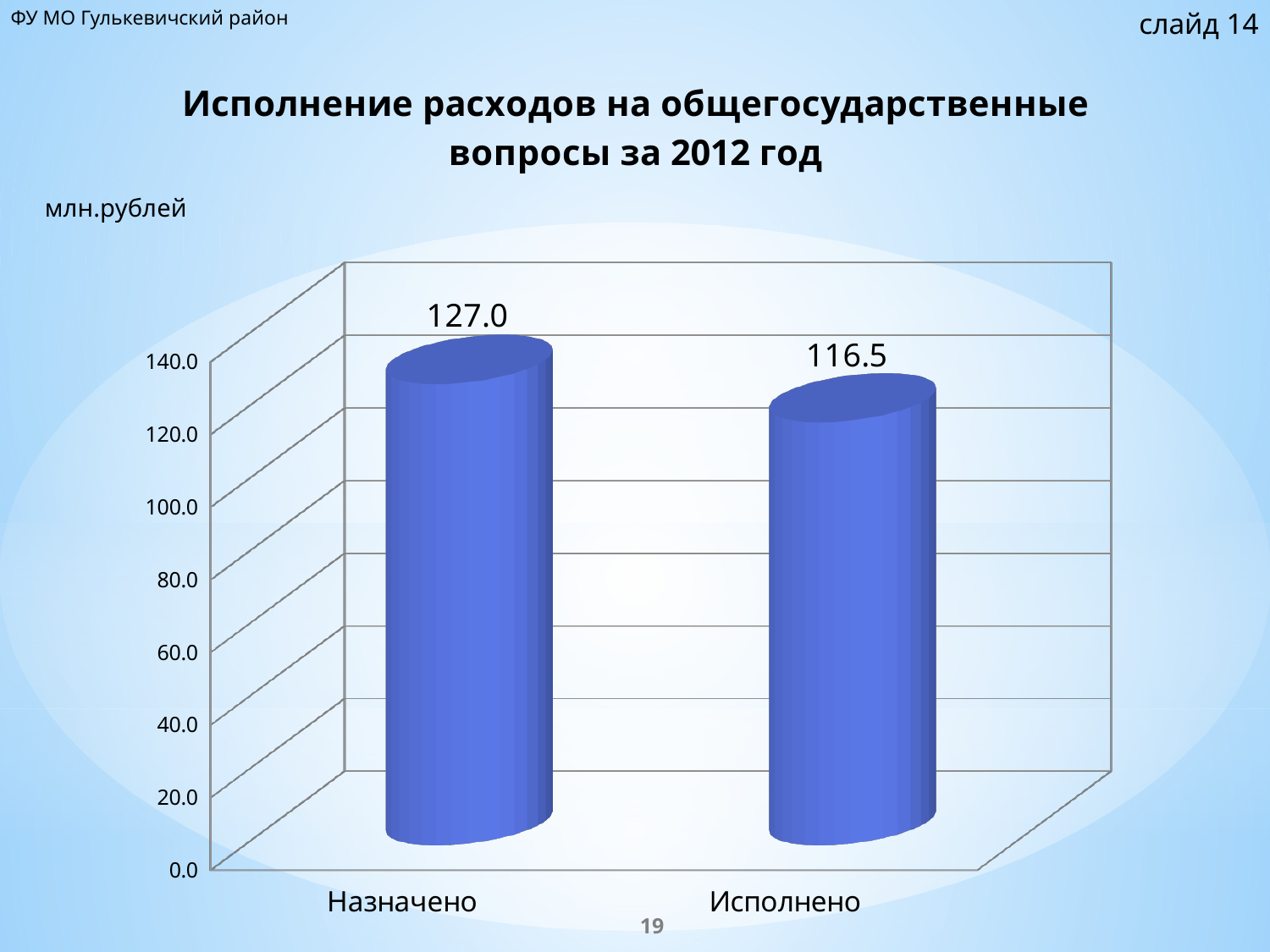
What is the value for Назначено? 127.0 Which category has the lowest value? Исполнено Is the value for Исполнено greater or less than 120.0? less How many categories are shown on the chart? 2 What is the difference between the values for Назначено and Исполнено? 10.5 What is the value for Исполнено? 116.5 What unit of measurement is indicated for the chart values? млн.рублей What kind of chart is shown on the slide? bar chart Which is larger, the value for Назначено or the value for Исполнено? Назначено What is the title of the chart? Исполнение расходов на общегосударственные вопросы за 2012 год Which category has the highest value? Назначено Is the value for Назначено greater or less than 120.0? greater